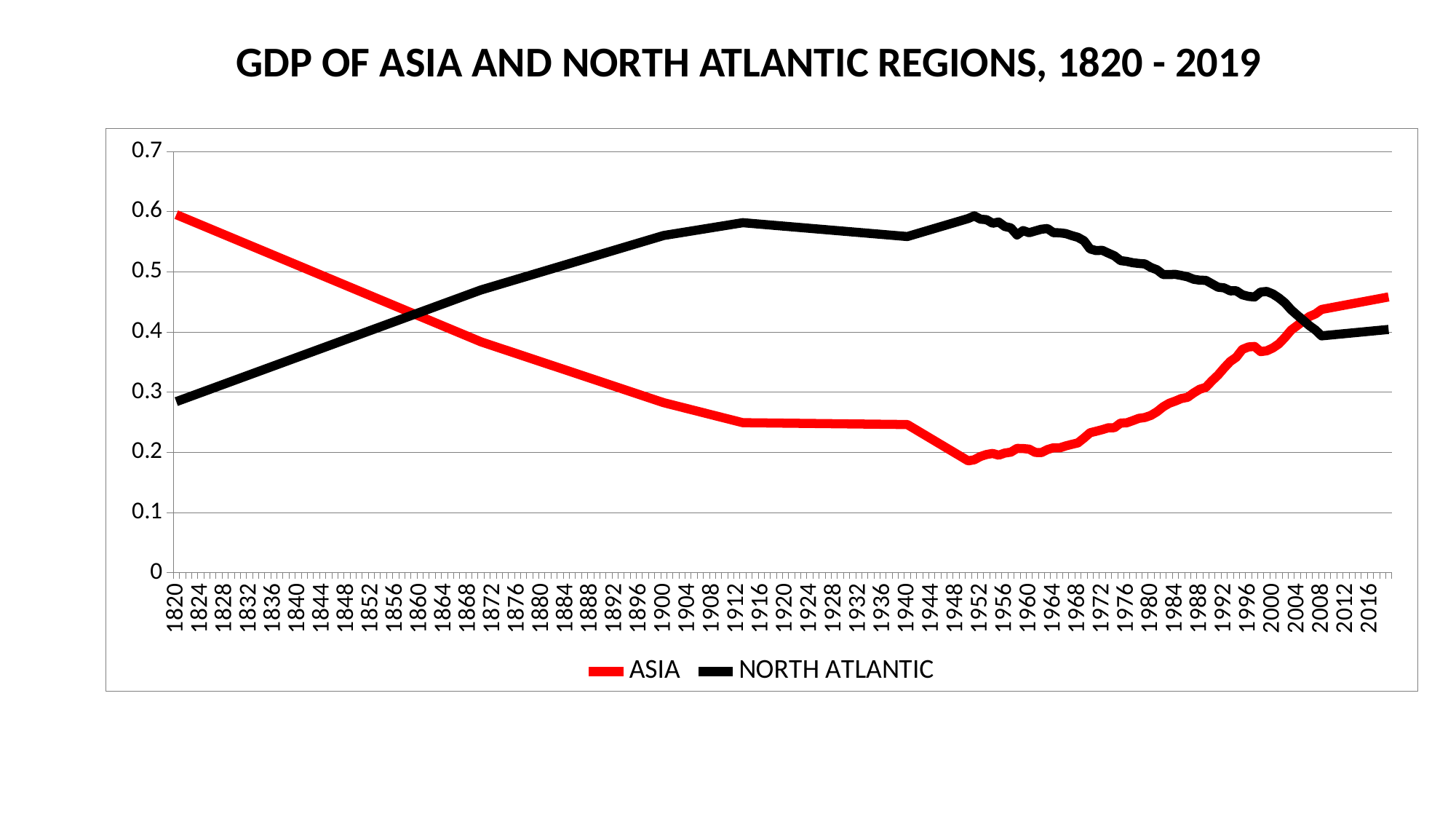
Is the value for NORTH ATLANTIC in 1820 greater or less than 0.3? less Does the ASIA line rise or fall between 1820 and 1912? fall What is the title of the chart? GDP OF ASIA AND NORTH ATLANTIC REGIONS, 1820 - 2019 How many series does the legend list? 2 In 1952, which series has the larger value, ASIA or NORTH ATLANTIC? NORTH ATLANTIC Is the value for ASIA in 1820 greater or less than 0.5? greater What kind of chart is shown on the slide? line chart In 1820, which series has the larger value, ASIA or NORTH ATLANTIC? ASIA Is the value for NORTH ATLANTIC in 1912 greater or less than 0.5? greater Which colour is used for the NORTH ATLANTIC line? black Does the NORTH ATLANTIC line rise or fall between 1820 and 1912? rise